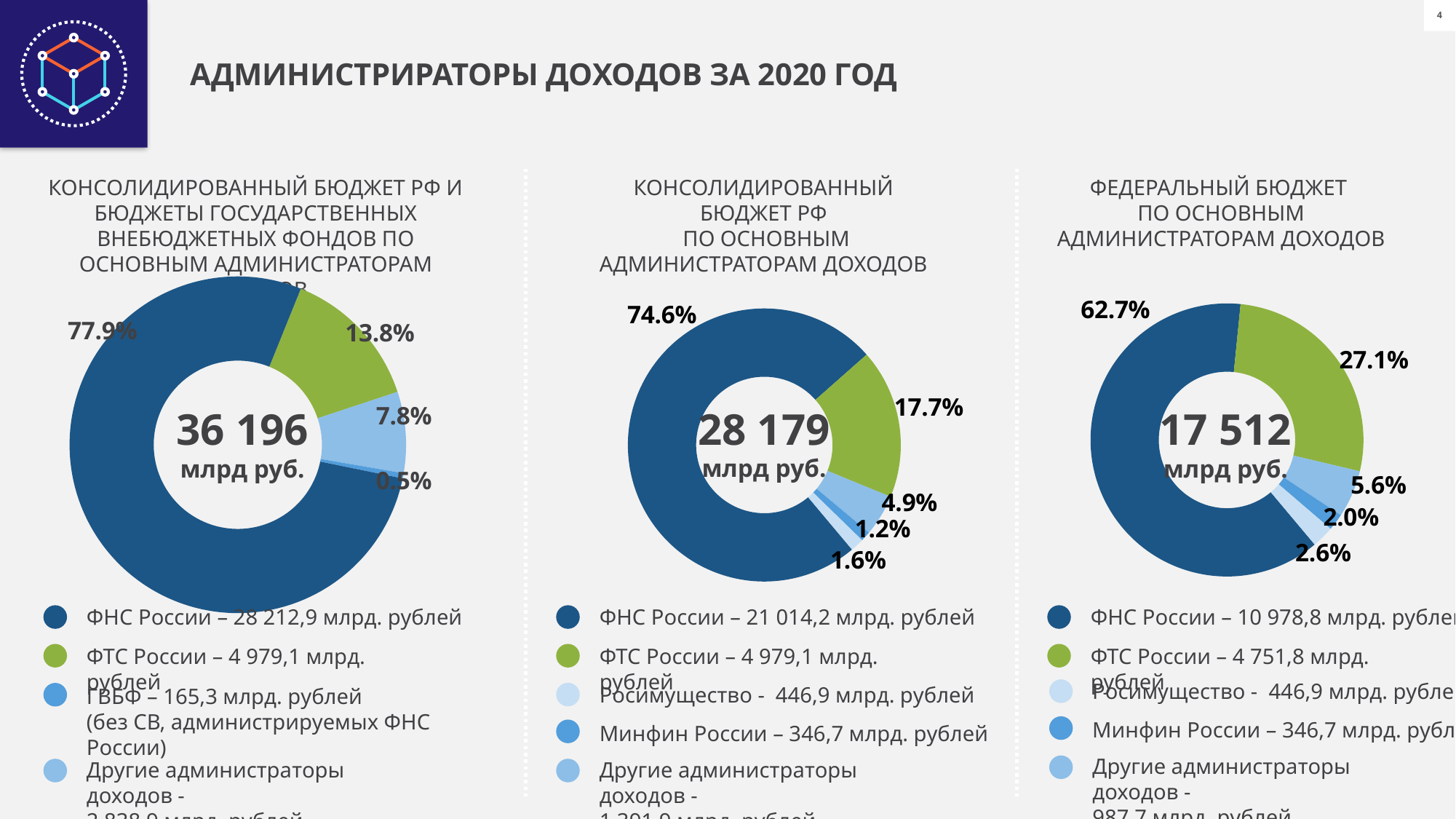
What kind of chart is used on this slide for each of the three budgets? Pie (donut) chart In the middle chart (Консолидированный бюджет РФ по основным администраторам доходов), what share does ФТС России hold? 17.7% In the left chart (Консолидированный бюджет РФ и бюджеты государственных внебюджетных фондов), what is the total shown in the centre of the donut? 36 196 млрд руб. In the left chart (Консолидированный бюджет РФ и бюджеты государственных внебюджетных фондов), which administrator has the smallest share? ГВБФ In the middle chart (Консолидированный бюджет РФ по основным администраторам доходов), what is the revenue amount for Минфин России according to the legend? 346,7 млрд. рублей Which is larger: the ФНС России share in the middle chart (Консолидированный бюджет РФ) or the ФНС России share in the right chart (Федеральный бюджет)? The middle chart (74.6%) In the right chart (Федеральный бюджет по основным администраторам доходов), what is the difference in percentage points between the ФНС России share and the ФТС России share? 35.6 percentage points In the right chart (Федеральный бюджет по основным администраторам доходов), which administrator has the largest share? ФНС России In the middle chart (Консолидированный бюджет РФ по основным администраторам доходов), how many slices does the donut have? 5 In the left chart (Консолидированный бюджет РФ и бюджеты государственных внебюджетных фондов), what share does ФНС России hold? 77.9% In the right chart (Федеральный бюджет по основным администраторам доходов), what is the total shown in the centre of the donut? 17 512 млрд руб. In the right chart (Федеральный бюджет по основным администраторам доходов), what share does ФТС России hold? 27.1%